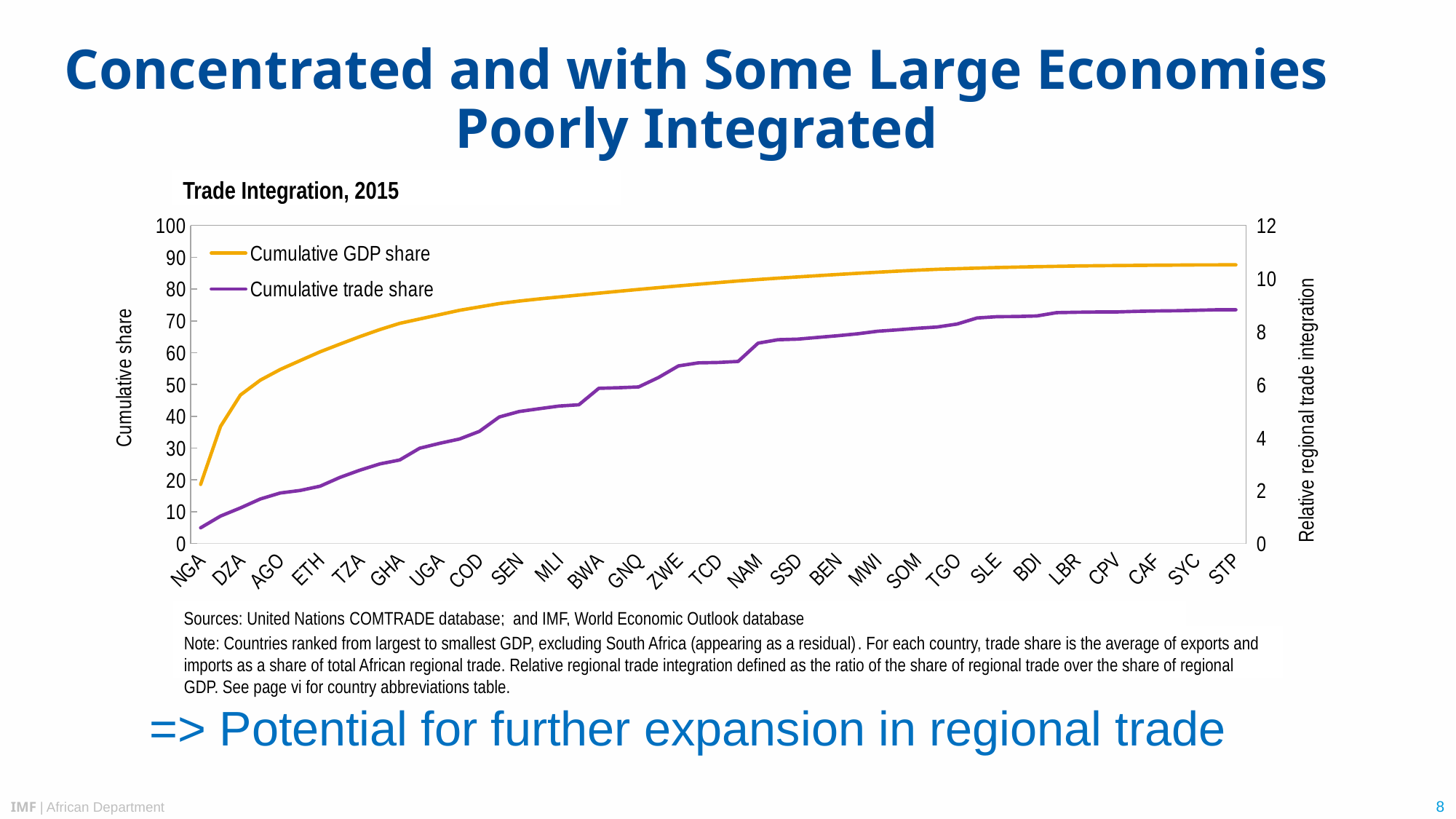
Is the Cumulative trade share value at STP greater or less than 60? greater What is the label of the right-hand vertical axis? Relative regional trade integration At DZA, which series has the larger value, Cumulative GDP share or Cumulative trade share? Cumulative GDP share How many country labels are shown along the x axis of the chart? 27 What kind of chart is shown on the slide? line chart Does the Cumulative trade share line rise or fall along the x axis? rise Is the Cumulative trade share value at NGA greater or less than 10? less Is the Cumulative GDP share value at STP greater or less than 80? greater How many series does the chart legend list? 2 Does the Cumulative GDP share line rise or fall from NGA to STP? rise What is the title of the chart? Trade Integration, 2015